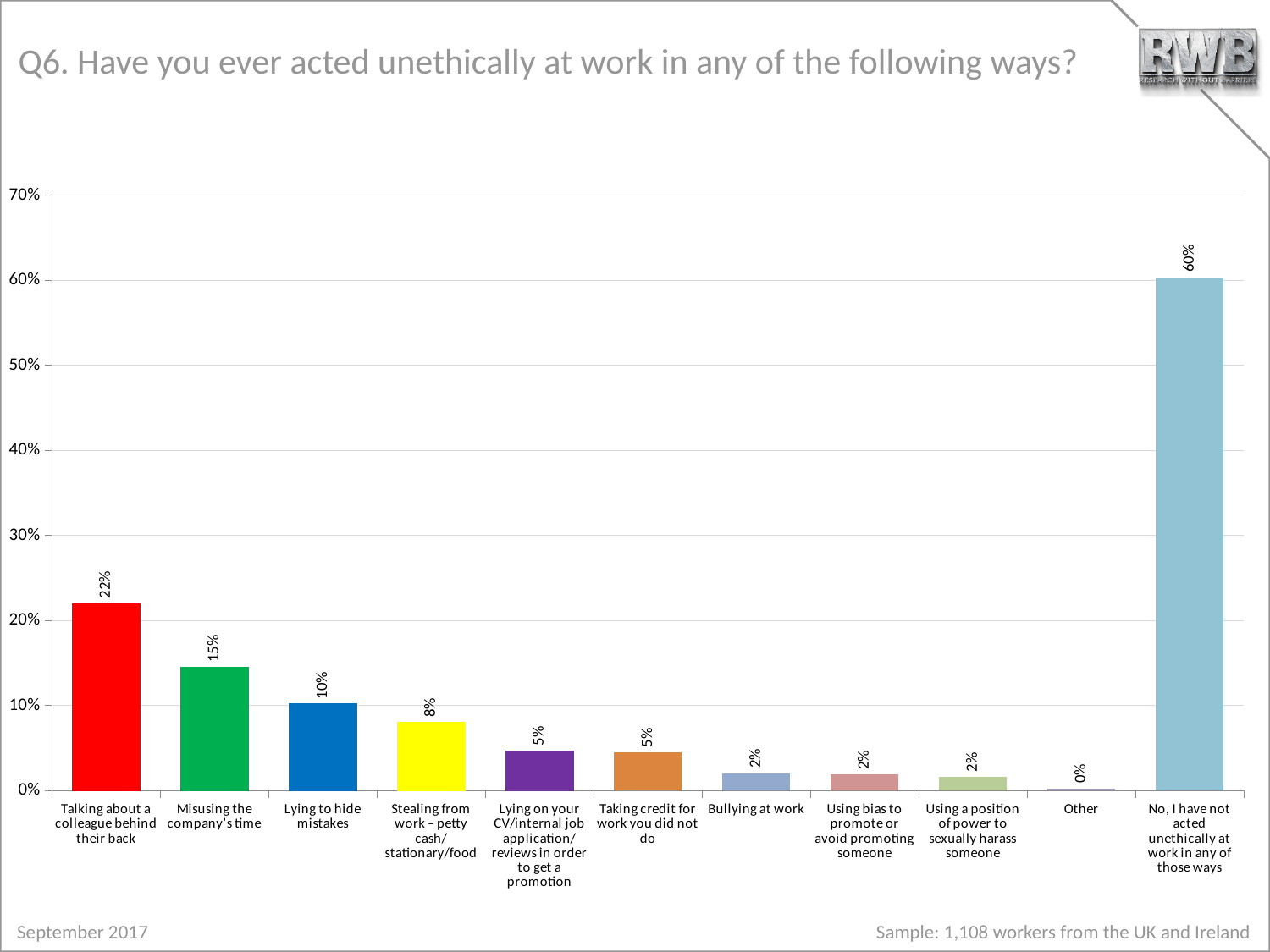
Is the value for 'No, I have not acted unethically at work in any of those ways' greater or less than 50%? greater What is the value for 'Lying on your CV/internal job application/reviews in order to get a promotion'? 5% How many categories are shown on the chart? 11 What is the sample size stated on the slide? 1,108 workers from the UK and Ireland Which is larger: 'Misusing the company's time' or 'Stealing from work – petty cash/stationary/food'? Misusing the company's time What is the value for 'Misusing the company's time'? 15% What kind of chart is shown on the slide? Bar chart Which category has the lowest value? Other Which category has the highest value? No, I have not acted unethically at work in any of those ways What percentage is shown for 'Bullying at work'? 2% What is the difference between 'Talking about a colleague behind their back' and 'Lying to hide mistakes'? 12% What percentage of respondents said they had talked about a colleague behind their back? 22%